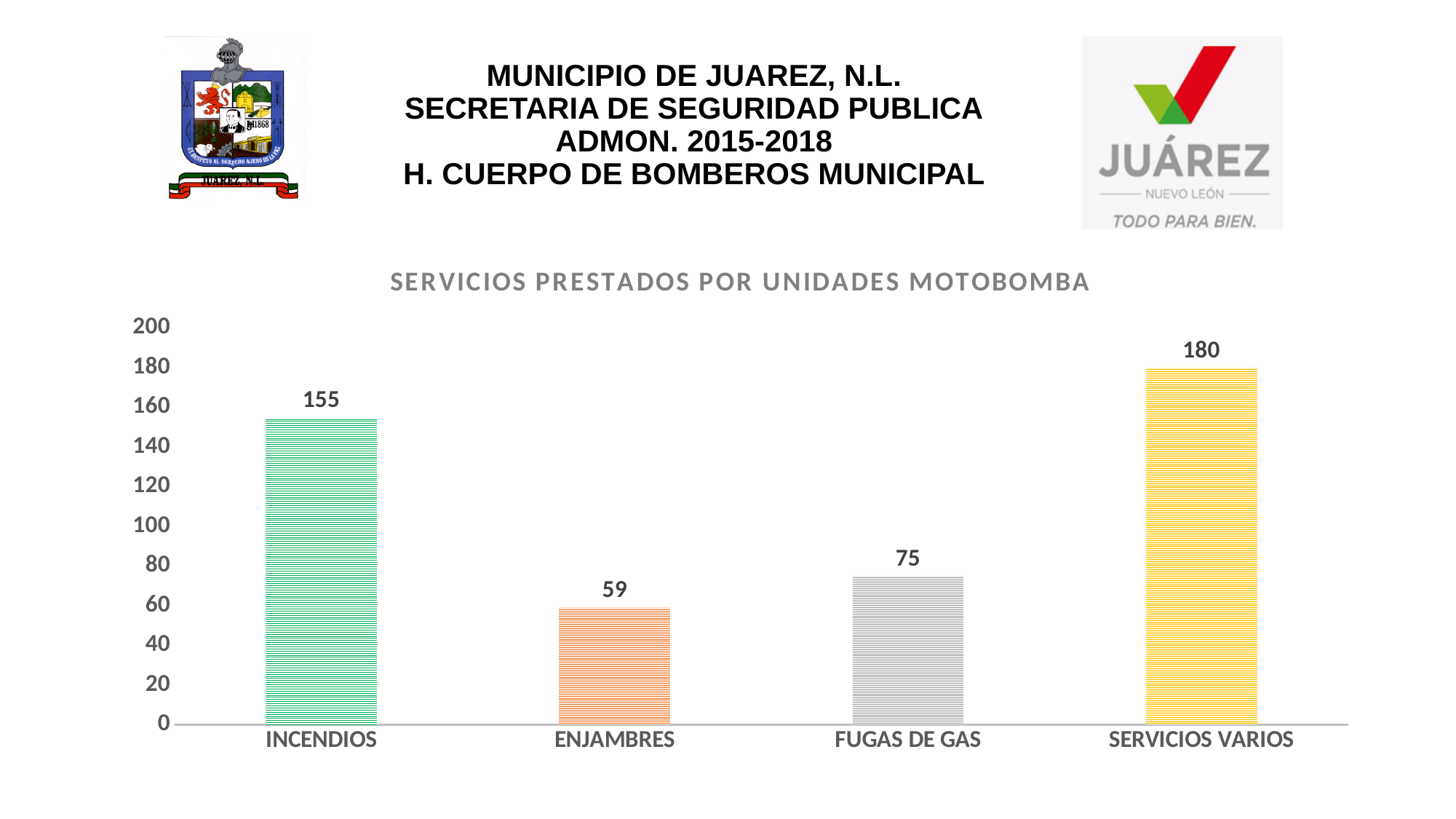
What is the value for ENJAMBRES? 59 Which is larger, the value for INCENDIOS or the value for FUGAS DE GAS? INCENDIOS What is the value for SERVICIOS VARIOS? 180 What kind of chart is shown on the slide? bar chart What is the value for INCENDIOS? 155 Which category has the lowest value? ENJAMBRES How many categories are shown on the x axis? 4 What is the difference between the values for FUGAS DE GAS and ENJAMBRES? 16 What is the difference between the values for SERVICIOS VARIOS and INCENDIOS? 25 What is the title of the chart? SERVICIOS PRESTADOS POR UNIDADES MOTOBOMBA What is the value for FUGAS DE GAS? 75 Which category has the highest value? SERVICIOS VARIOS